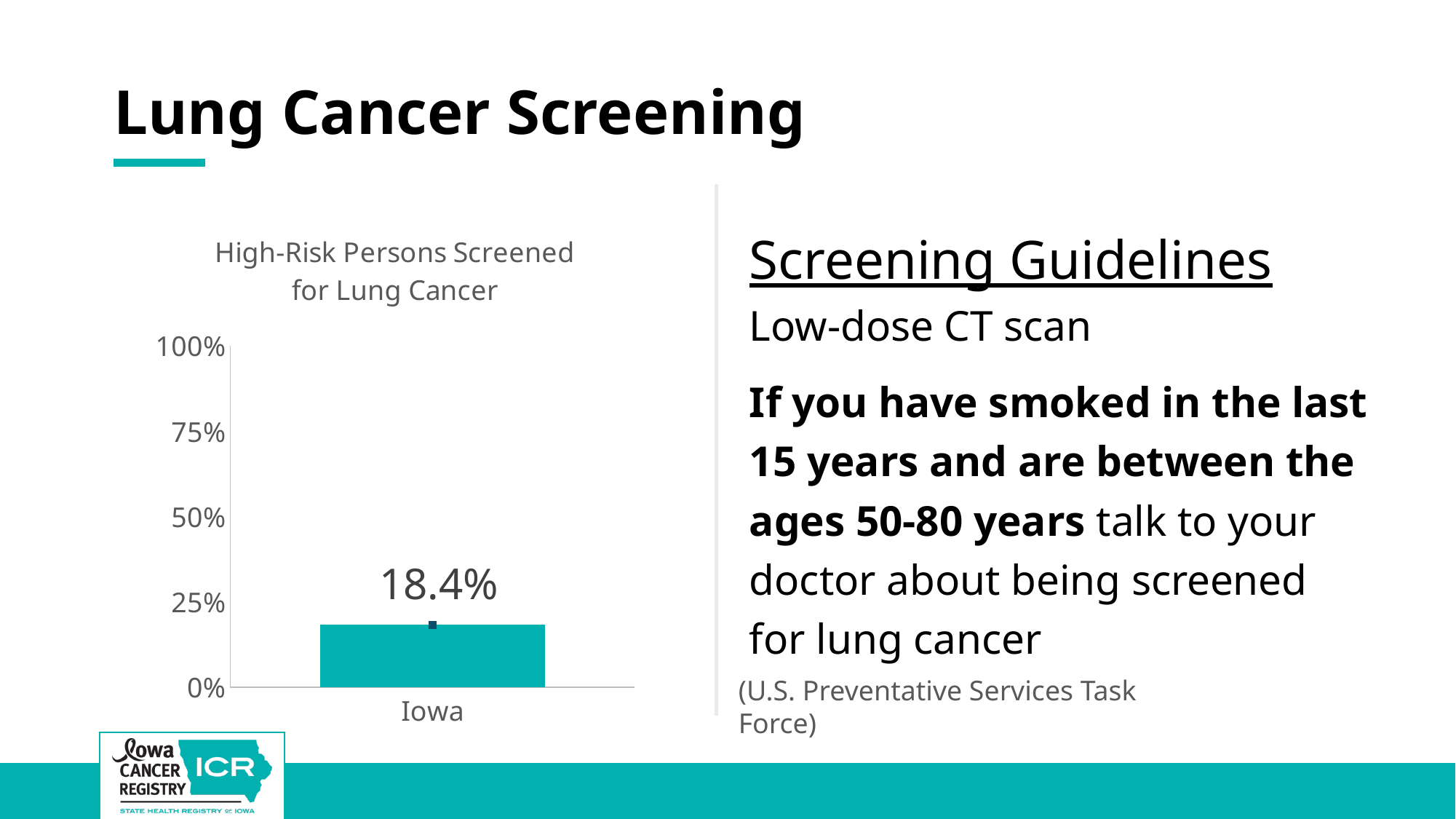
What is the value for Iowa in the chart? 18.4% What is the title of the chart? High-Risk Persons Screened for Lung Cancer Is the value for Iowa greater or less than 25%? less How many categories are plotted in the chart? 1 Is the value for Iowa greater or less than 50%? less Which category is labelled on the x axis of the chart? Iowa What kind of chart is shown on the slide? bar chart What is the highest value shown on the chart's vertical axis? 100%